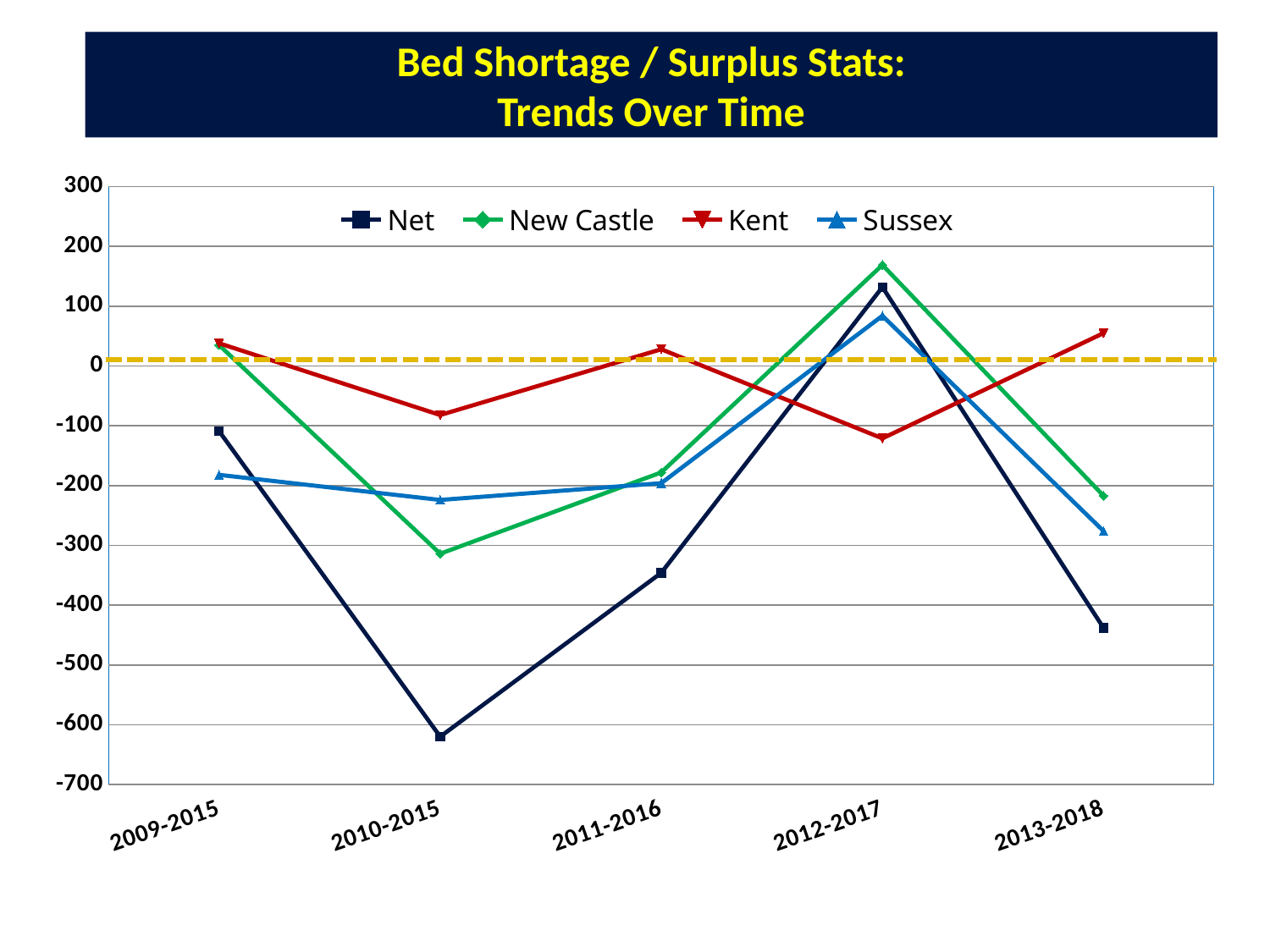
How many time periods are shown along the x axis? 5 How many series does the legend list? 4 In which period does the Net series reach its highest value? 2012-2017 In which period does the Kent series reach its lowest value? 2012-2017 Is the value for New Castle in 2012-2017 greater or less than 100? greater In which period does the Net series reach its lowest value? 2010-2015 What is the title of the chart? Bed Shortage / Surplus Stats: Trends Over Time What kind of chart is shown on the slide? line chart Is the value for Net in 2010-2015 greater or less than -500? less Does the Net series rise or fall from 2012-2017 to 2013-2018? fall Is the value for Sussex in 2013-2018 greater or less than -200? less In 2010-2015, which is larger: the value for Kent or the value for Net? Kent